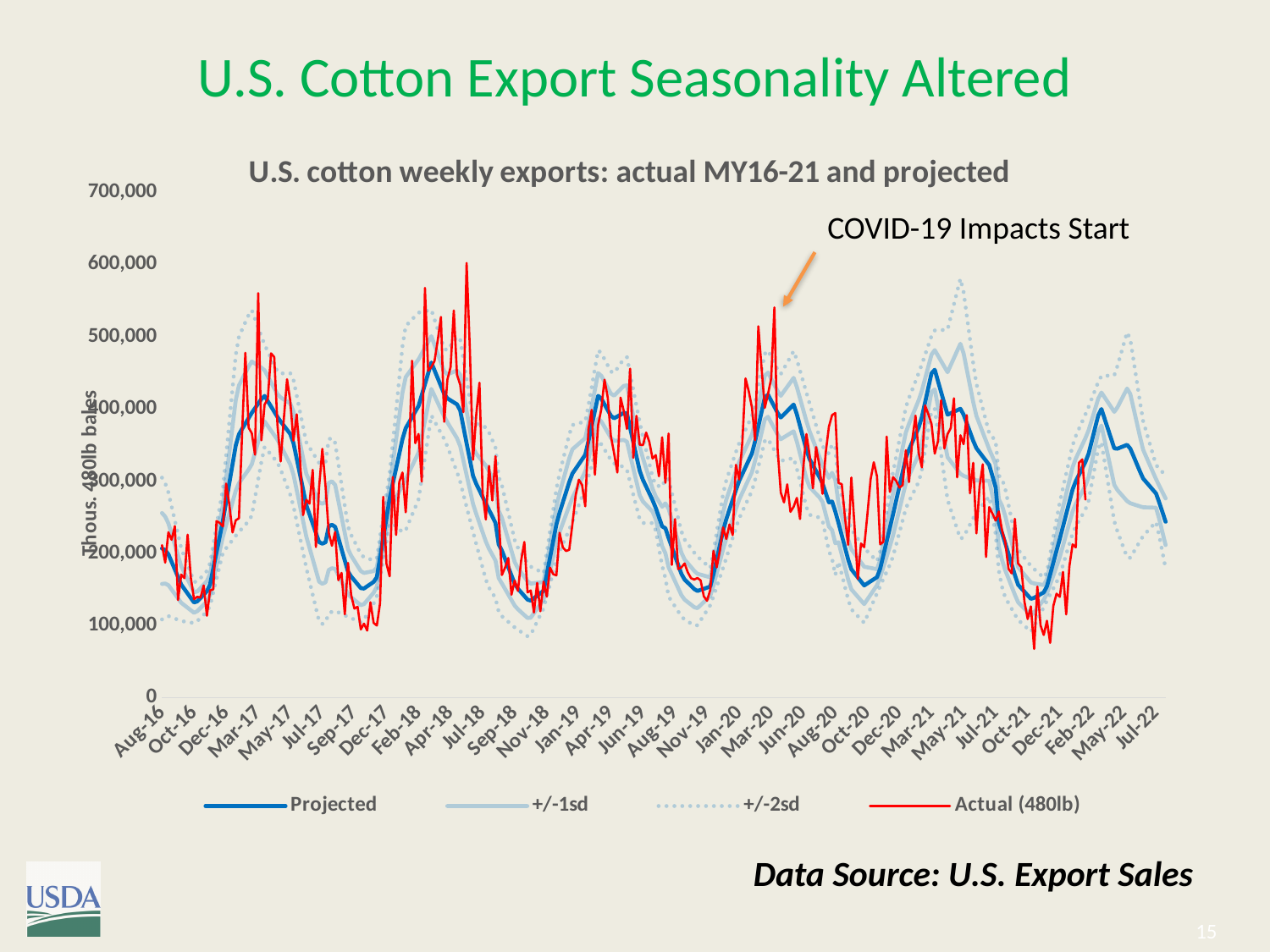
Does the Actual (480lb) series rise or fall between Nov-21 and Feb-22? Rise Is the peak of the Projected series around Mar-21 greater or less than 400,000? greater What is the label on the vertical axis of the chart? Thous. 480lb bales What kind of chart is shown on the slide? Line chart Does the Projected series rise or fall between Mar-21 and Oct-21? Fall Is the lowest value of the Actual (480lb) series around Nov-21 greater or less than 100,000? less What is the title of the chart? U.S. cotton weekly exports: actual MY16-21 and projected How many series does the legend list? 4 Is the peak value of the Actual (480lb) series around Jul-18 greater or less than 500,000? greater Which series reaches a higher peak overall, Projected or Actual (480lb)? Actual (480lb)